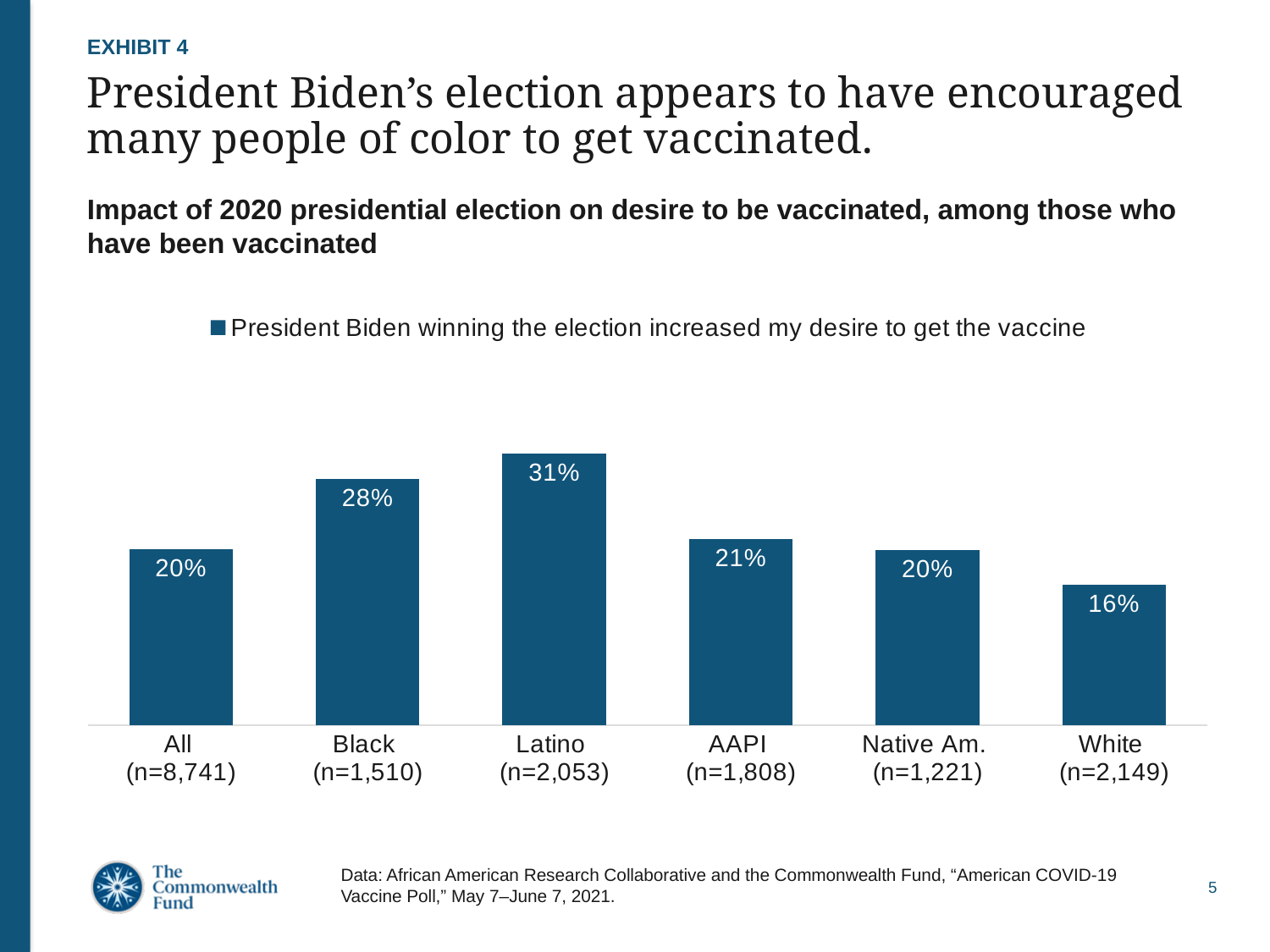
What type of chart is shown on the slide? Bar chart Which is larger, the value for Black or the value for AAPI? Black How many groups are shown on the x axis of the chart? 6 What is the value shown for the All group? 20% Which group has the highest value in the chart? Latino What is the value shown for the AAPI group? 21% What is the sample size (n) shown for the Native Am. group? n=1,221 How many series does the legend list? 1 What is the difference between the values for Black and White respondents? 12 percentage points Which group has the lowest value in the chart? White What percentage of Latino respondents said President Biden winning the election increased their desire to get the vaccine? 31% What is the value shown for the White group? 16%